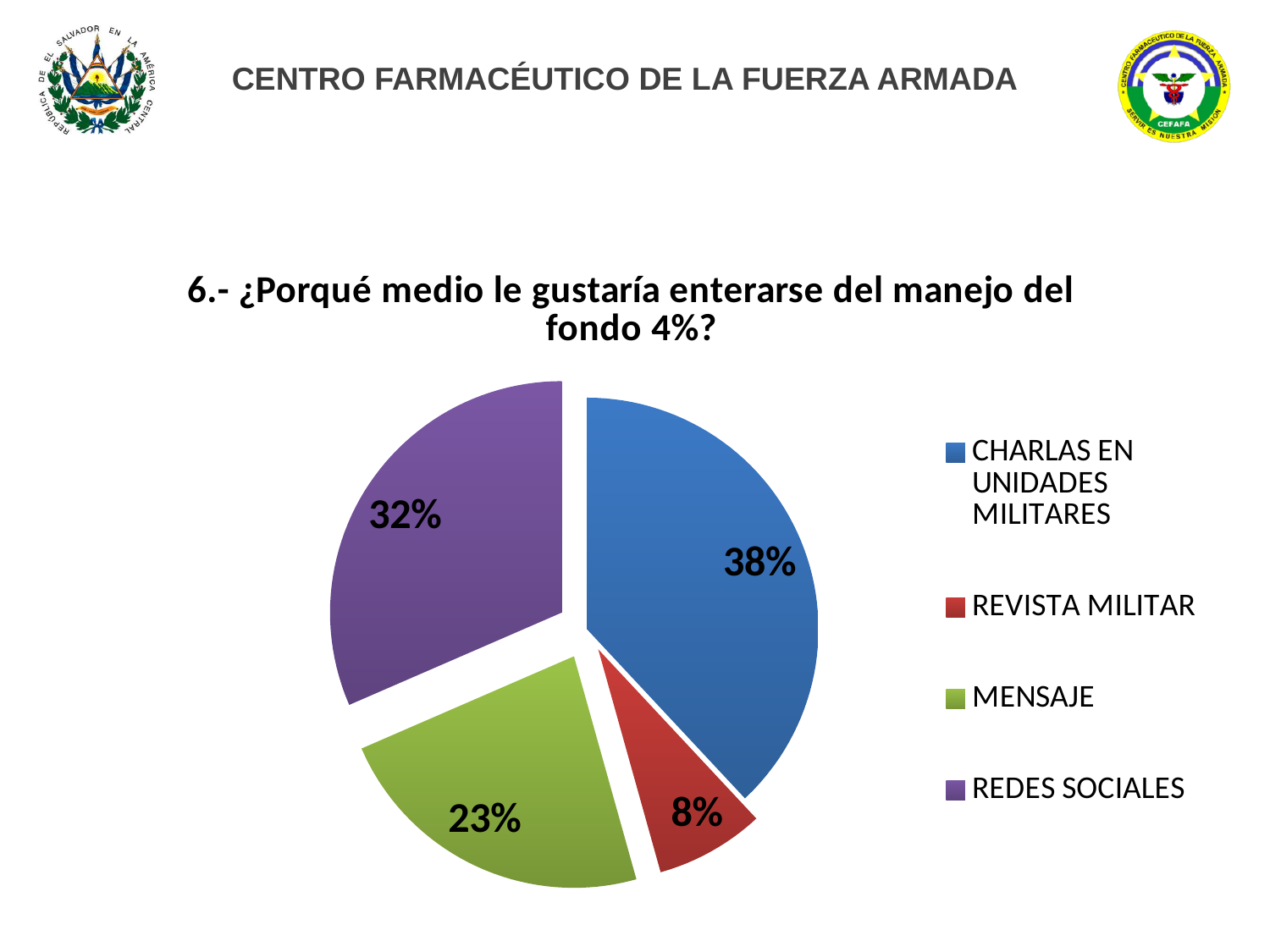
What kind of chart is shown on the slide? Pie chart What percentage of the pie corresponds to REVISTA MILITAR? 8% What is the difference in percentage points between CHARLAS EN UNIDADES MILITARES and REDES SOCIALES? 6 What is the title of the chart? 6.- ¿Porqué medio le gustaría enterarse del manejo del fondo 4%? Which category has the smallest share of the pie? REVISTA MILITAR Which is larger, the share for MENSAJE or the share for REDES SOCIALES? REDES SOCIALES What percentage of the pie corresponds to REDES SOCIALES? 32% What percentage of the pie corresponds to MENSAJE? 23% What percentage of the pie corresponds to CHARLAS EN UNIDADES MILITARES? 38% Which category has the largest share of the pie? CHARLAS EN UNIDADES MILITARES What colour is the slice for MENSAJE? Green How many categories does the pie chart show? 4